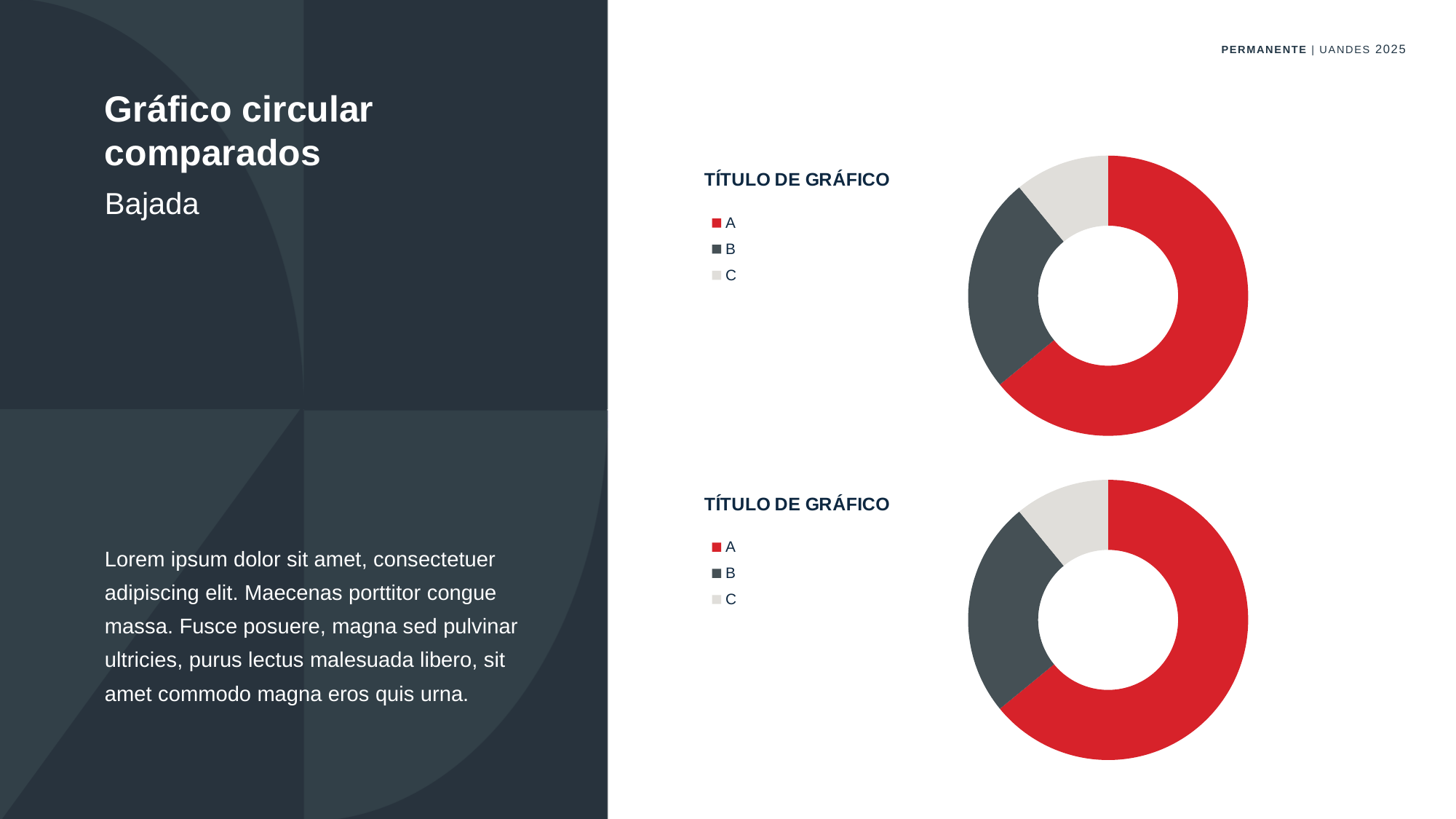
In the bottom chart, what colour represents category A in the legend? red In the bottom chart, which slice is larger, A or B? A In the top chart, which slice is larger, B or C? B In the top chart, how many categories does the legend list? 3 What kind of chart is the top chart on the slide? doughnut chart In the top chart, which category has the largest slice? A What kind of chart is the bottom chart on the slide? doughnut chart What is the title of the top chart? TÍTULO DE GRÁFICO In the bottom chart, which category has the smallest slice? C In the bottom chart, how many slices does the doughnut have? 3 In the bottom chart, which category has the largest slice? A In the top chart, which category has the smallest slice? C